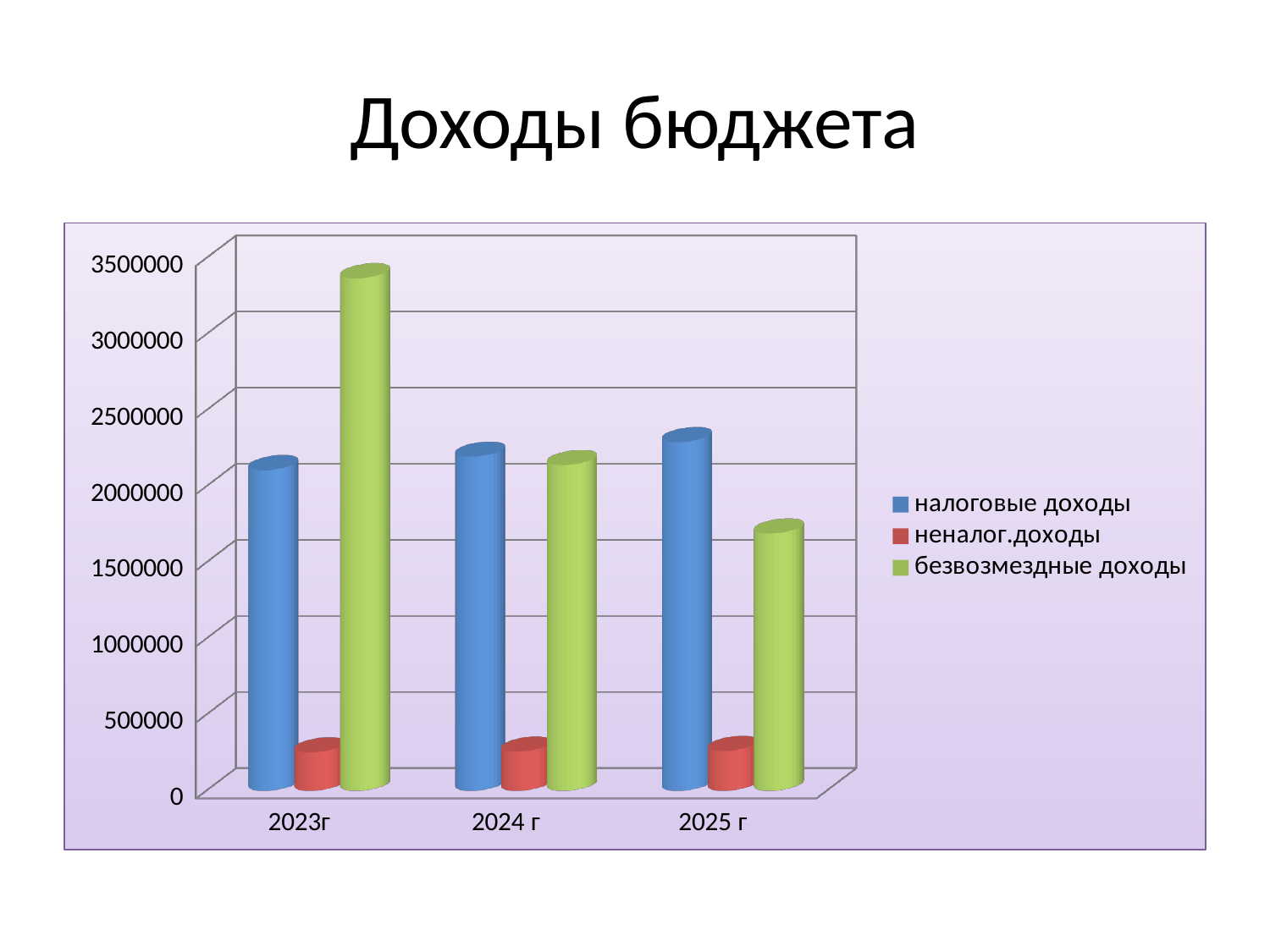
What is the title of the chart? Доходы бюджета How many series does the legend list? 3 Which series has the lowest bar in 2025 г? неналог.доходы How many categories are shown on the x axis? 3 Which series has the tallest bar in 2023г? безвозмездные доходы Is the value for неналог.доходы in 2024 г greater or less than 500000? less Is the value for безвозмездные доходы in 2025 г greater or less than 2000000? less In 2025 г, which is larger: налоговые доходы or безвозмездные доходы? налоговые доходы Do the values for безвозмездные доходы rise or fall from 2023г to 2025 г? fall Is the value for безвозмездные доходы in 2023г greater or less than 3000000? greater What kind of chart is shown on the slide? bar chart